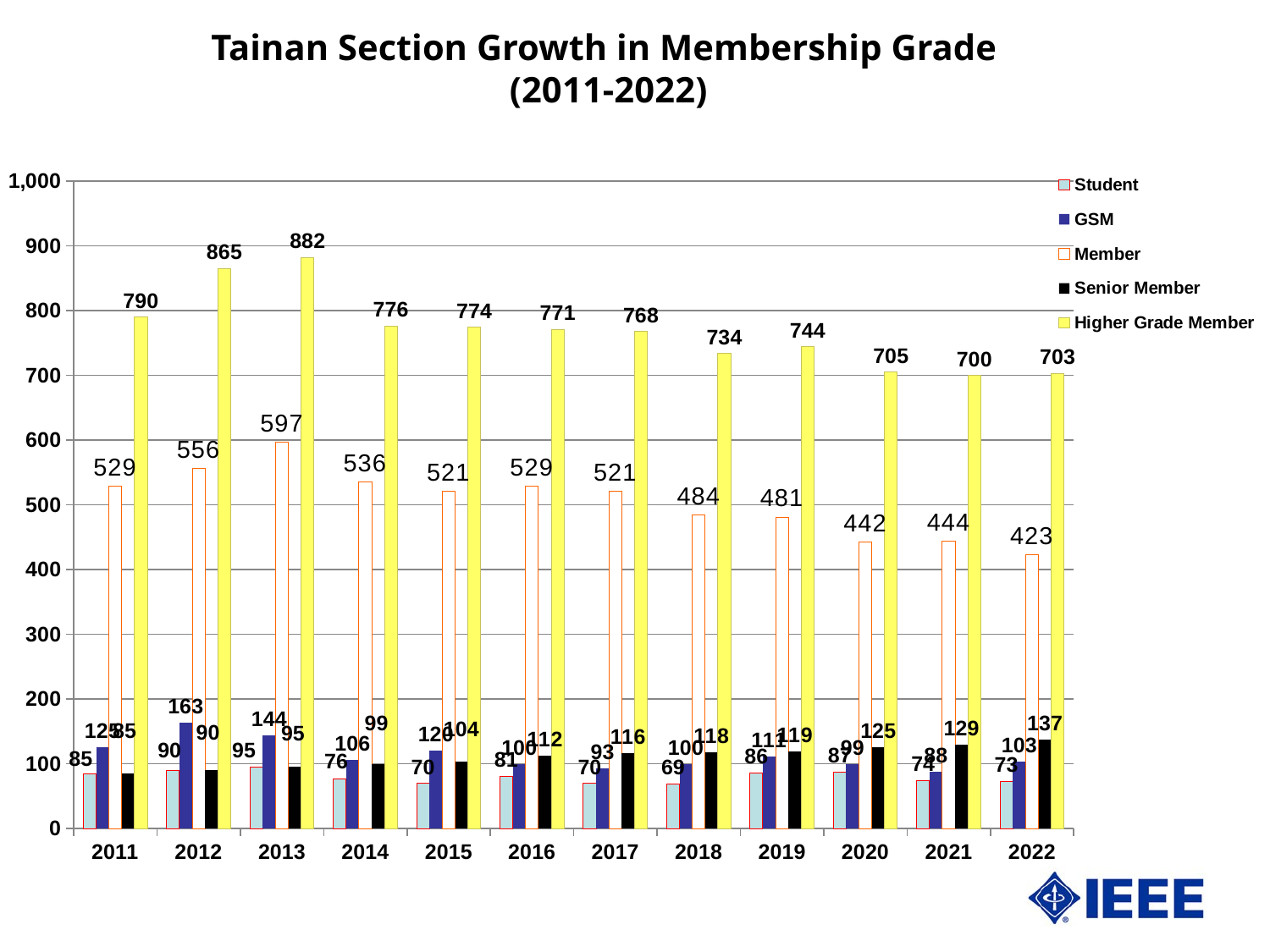
In which year is the Student value lowest? 2018 What type of chart is shown on the slide? bar chart What is the Member value for 2022? 423 In which year is the Higher Grade Member value highest? 2013 What is the Higher Grade Member value for 2013? 882 What is the difference between the Higher Grade Member values for 2012 and 2022? 162 What is the Senior Member value for 2022? 137 Does the Senior Member value rise or fall from 2011 to 2022? rise How many years are shown on the x axis? 12 Which is larger, the Member value for 2011 or the Member value for 2021? 2011 How many series does the legend list? 5 What is the GSM value for 2012? 163